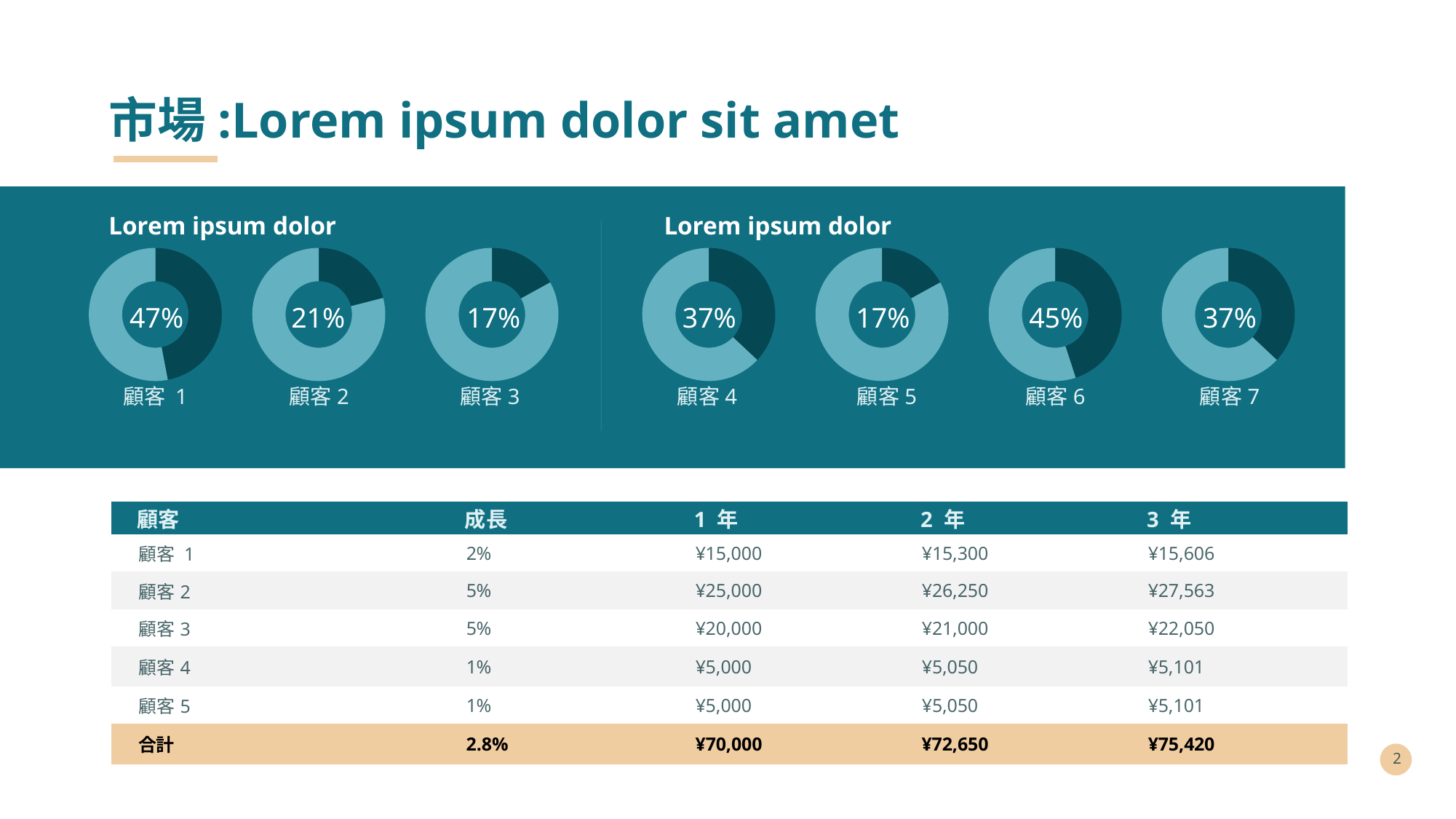
Which two donut charts both show 17%? 顧客 3 and 顧客 5 What percentage is shown in the donut chart labelled 顧客 6? 45% How many donut charts are in the right-hand group under the second 'Lorem ipsum dolor' heading? 4 How many donut charts are shown on the slide in total? 7 What percentage is shown in the donut chart labelled 顧客 1? 47% What kind of chart is used to display the percentage for each 顧客? Donut chart Which donut chart in the left group (顧客 1 to 顧客 3) shows the lowest percentage? 顧客 3 Which shows a larger percentage, the donut chart for 顧客 6 or the one for 顧客 7? 顧客 6 What is the difference between the percentages shown for 顧客 1 and 顧客 2? 26% What percentage is shown in the donut chart labelled 顧客 2? 21% Which of the seven donut charts shows the highest percentage? 顧客 1 What percentage is shown in the donut chart labelled 顧客 4? 37%